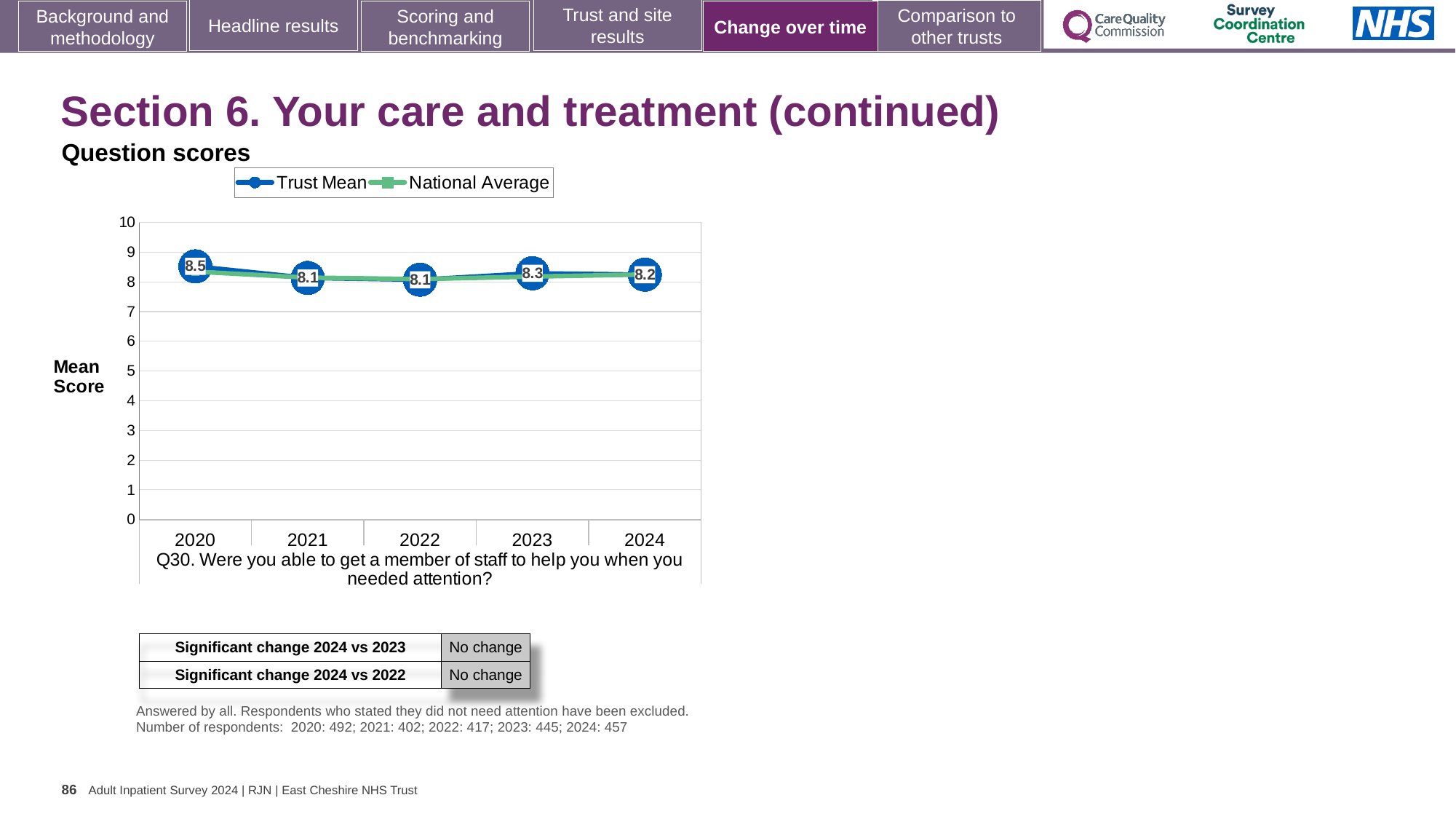
What is the difference between the Trust Mean score in 2020 and in 2021? 0.4 What is the label of the y axis of the chart? Mean Score What kind of chart is shown on the slide? line chart Does the Trust Mean score rise or fall from 2020 to 2021? fall In which year is the Trust Mean score highest? 2020 What is the Trust Mean score for 2020? 8.5 Is the Trust Mean score for 2022 greater or less than 9? less How many years are shown on the x axis of the chart? 5 How many series does the chart legend list? 2 Which is larger, the Trust Mean score for 2023 or for 2022? 2023 What is the Trust Mean score for 2024? 8.2 What is the Trust Mean score for 2023? 8.3